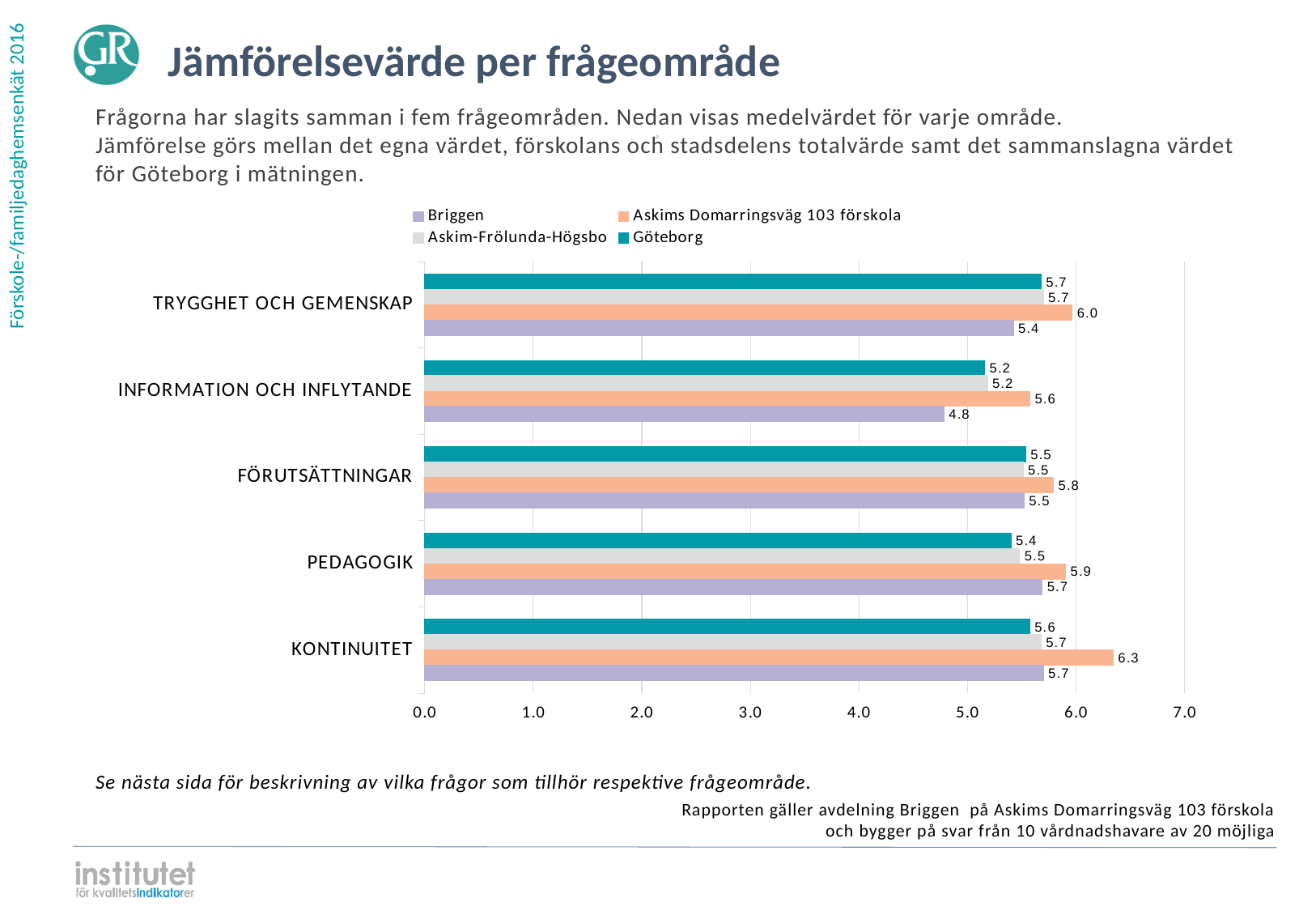
What is the value for Askim-Frölunda-Högsbo in TRYGGHET OCH GEMENSKAP? 5.7 What is the value for Göteborg in PEDAGOGIK? 5.4 How many categories (question areas) are shown on the chart? 5 What kind of chart is shown on the slide? Bar chart What is the value for Briggen in INFORMATION OCH INFLYTANDE? 4.8 What is the value for Askims Domarringsväg 103 förskola in KONTINUITET? 6.3 What is the difference between Askims Domarringsväg 103 förskola and Briggen in TRYGGHET OCH GEMENSKAP? 0.6 Which series is shown in orange in the legend? Askims Domarringsväg 103 förskola In which category does Askims Domarringsväg 103 förskola have its highest value? KONTINUITET In which category does Briggen have its lowest value? INFORMATION OCH INFLYTANDE How many series does the legend list? 4 Which is larger in PEDAGOGIK: the value for Briggen or the value for Göteborg? Briggen